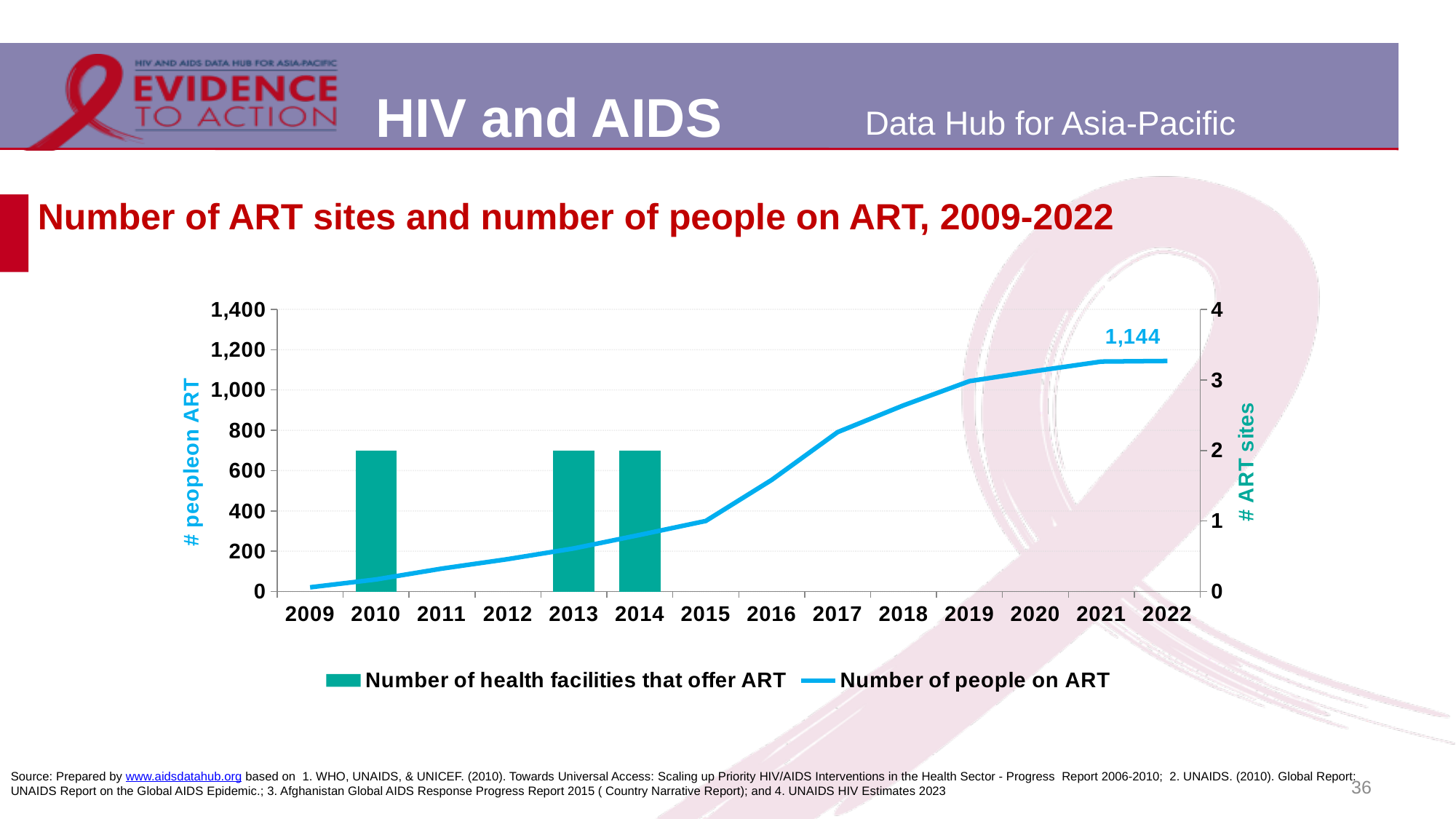
What is the number of health facilities that offer ART in 2013? 2 Is the number of people on ART in 2011 greater or less than 200? less Is the number of people on ART in 2017 greater or less than 600? greater How many years are shown on the x axis? 14 How many years have a bar for 'Number of health facilities that offer ART'? 3 What kind of chart is this? Combination bar and line chart What is the number of health facilities that offer ART in 2010? 2 Does the number of people on ART rise or fall from 2009 to 2022? Rise What is the title of the chart? Number of ART sites and number of people on ART, 2009-2022 Which series is plotted as a line? Number of people on ART How many series does the legend list? 2 What is the data label shown on the 'Number of people on ART' line at the end of the series? 1,144